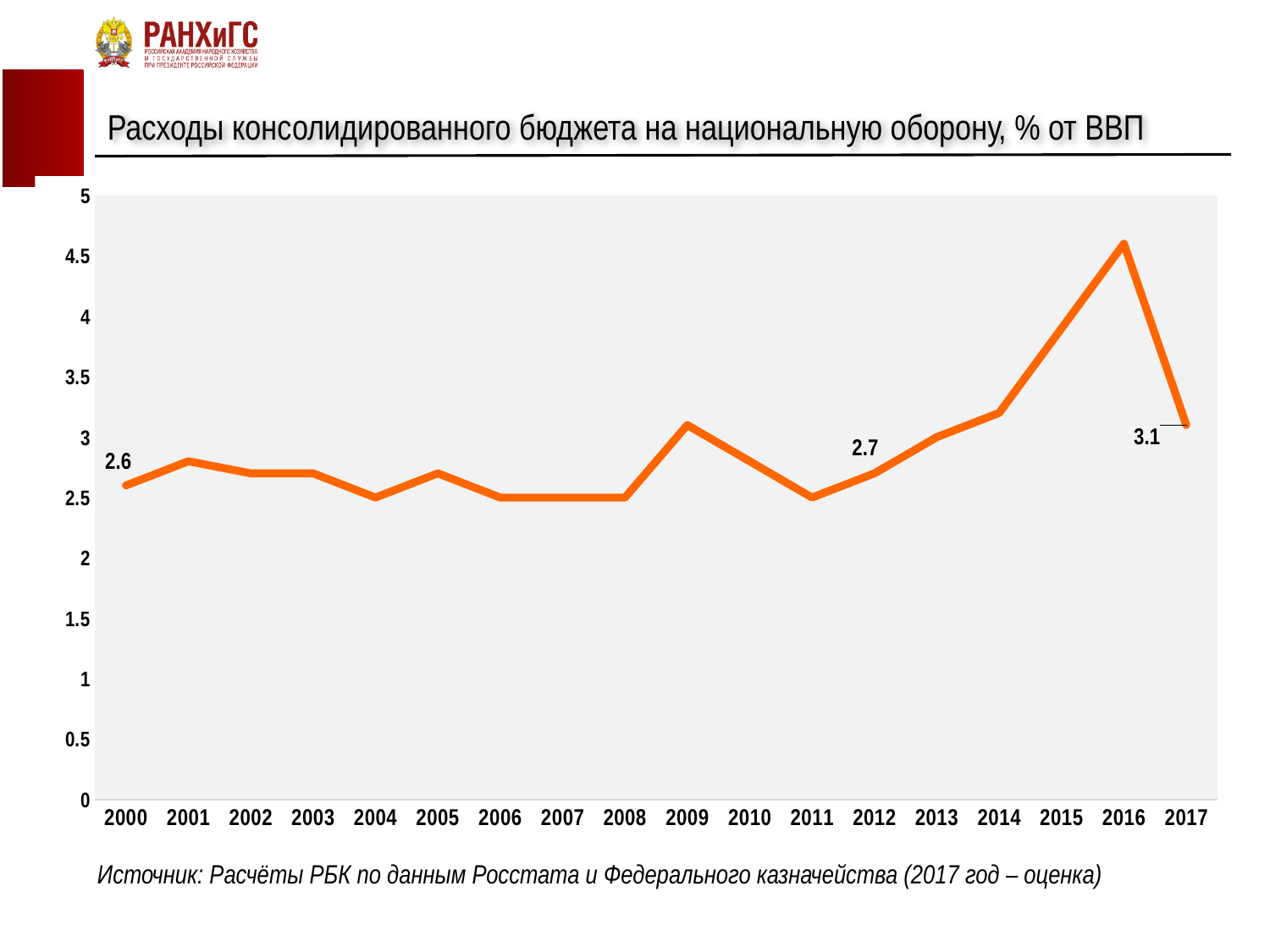
Is the value for 2016 greater or less than 4? greater What kind of chart is shown on the slide? line chart Which is larger, the value for 2000 or the value for 2017? 2017 What is the value for 2012? 2.7 Do the values rise or fall from 2014 to 2016? rise What is the value for 2017? 3.1 How many years are shown on the x axis? 18 Is the value for 2011 greater or less than 3? less Which year has the highest value? 2016 What is the value for 2000? 2.6 What is the difference between the values for 2017 and 2000? 0.5 What is the title of the chart? Расходы консолидированного бюджета на национальную оборону, % от ВВП